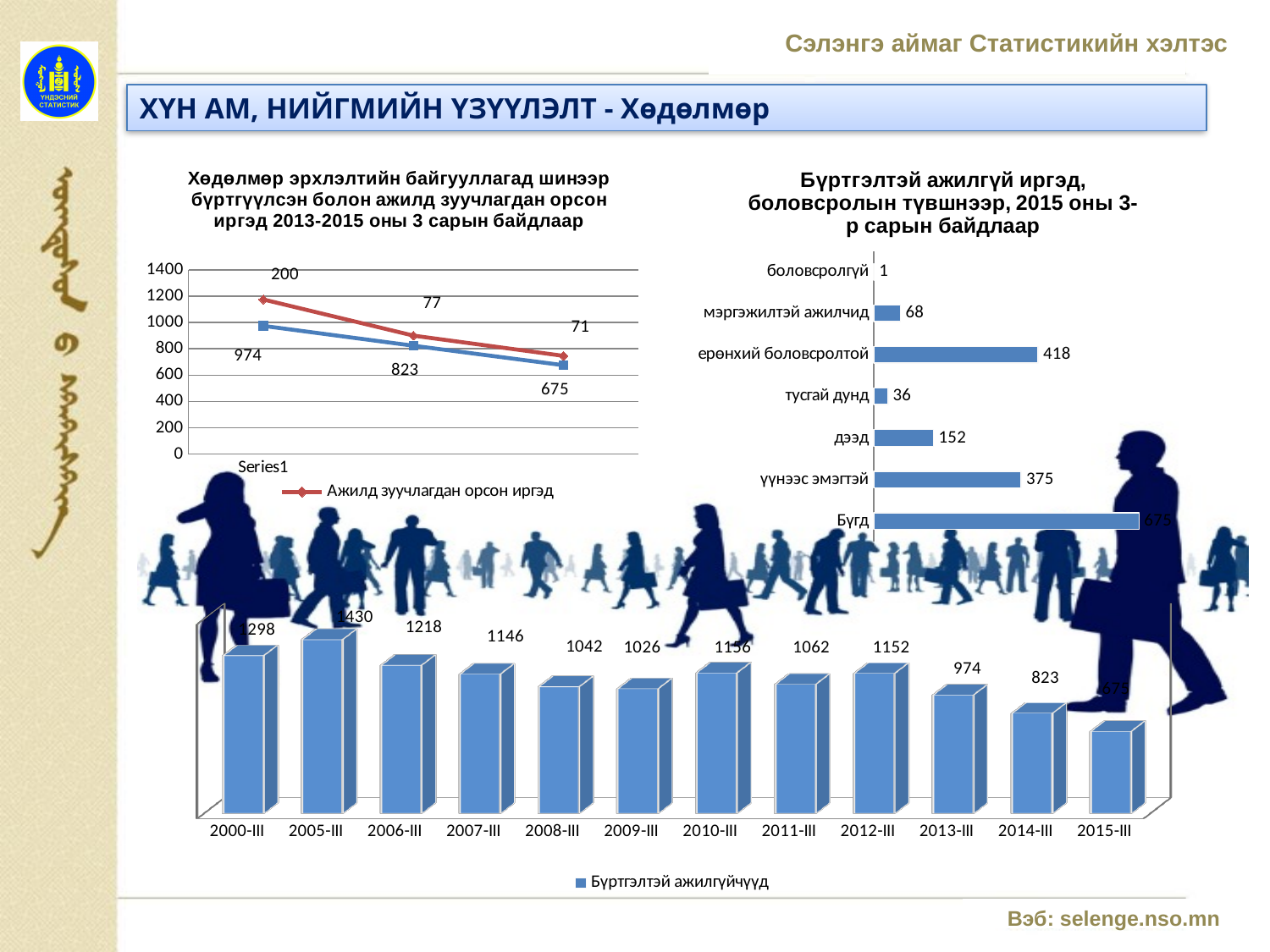
In the bottom bar chart (Бүртгэлтэй ажилгүйчүүд), what is the difference between the values for 2013-III and 2014-III? 151 In the chart titled 'Бүртгэлтэй ажилгүй иргэд, боловсролын түвшнээр, 2015 оны 3-р сарын байдлаар', which category has the lowest value? боловсролгүй In the bottom bar chart (Бүртгэлтэй ажилгүйчүүд), how many categories are shown on the x axis? 12 In the chart titled 'Бүртгэлтэй ажилгүй иргэд, боловсролын түвшнээр, 2015 оны 3-р сарын байдлаар', how many categories are listed? 7 In the chart titled 'Бүртгэлтэй ажилгүй иргэд, боловсролын түвшнээр, 2015 оны 3-р сарын байдлаар', what is the value for ерөнхий боловсролтой? 418 In the top-left line chart, what is the last data label on the blue line? 675 In the chart titled 'Бүртгэлтэй ажилгүй иргэд, боловсролын түвшнээр, 2015 оны 3-р сарын байдлаар', what is the value for дээд? 152 In the bottom bar chart (Бүртгэлтэй ажилгүйчүүд), which is larger: the value for 2010-III or the value for 2012-III? 2010-III What kind of chart is the one titled 'Бүртгэлтэй ажилгүй иргэд, боловсролын түвшнээр, 2015 оны 3-р сарын байдлаар'? Bar chart In the bottom bar chart (Бүртгэлтэй ажилгүйчүүд), what is the value for 2005-III? 1430 In the bottom bar chart (Бүртгэлтэй ажилгүйчүүд), which category has the highest value? 2005-III In the top-left line chart, do the values of the blue line rise or fall from left to right? Fall